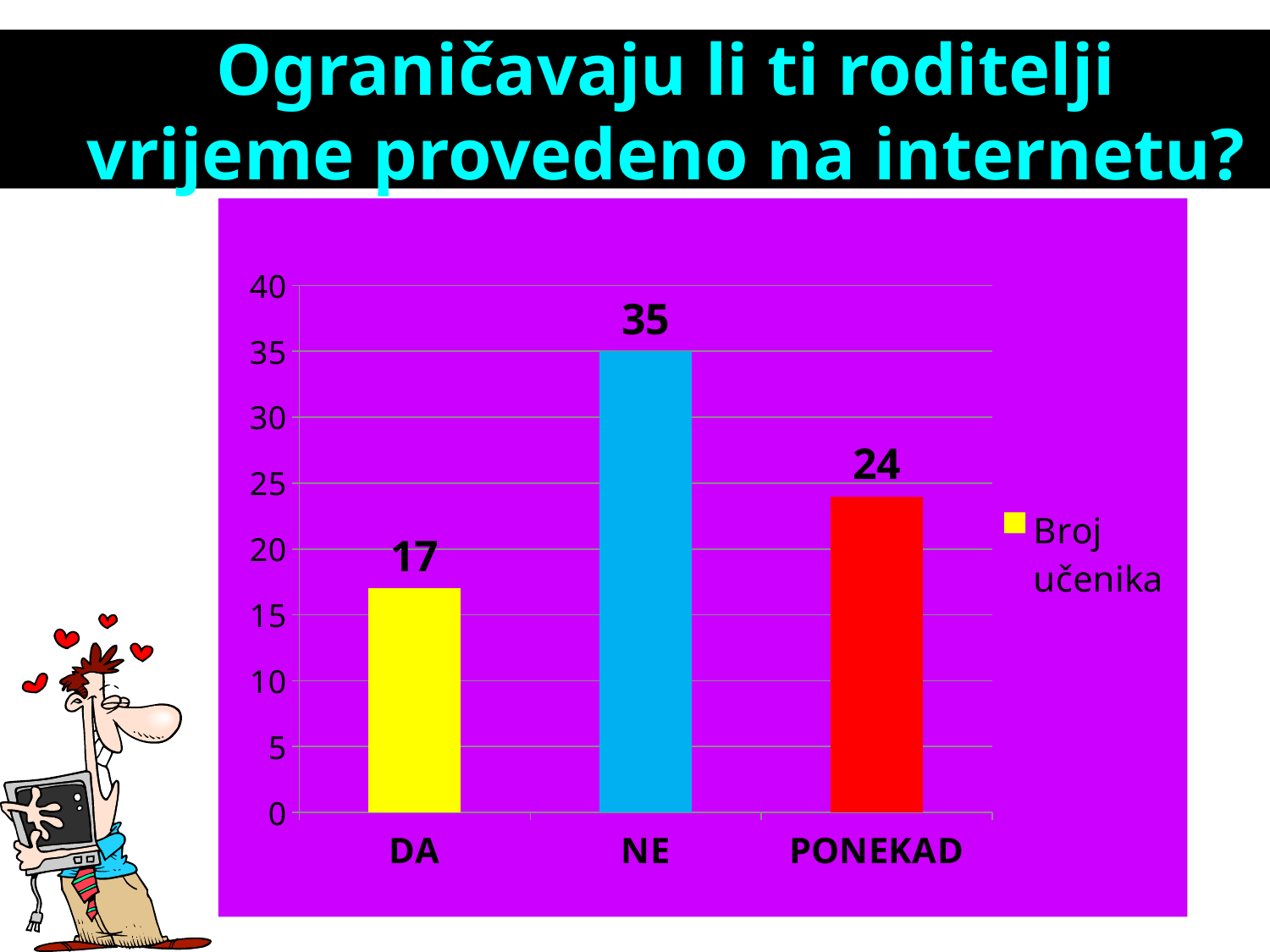
What is the difference between the values for PONEKAD and DA? 7 What is the value for DA? 17 What is the value for NE? 35 What is the value for PONEKAD? 24 What series name does the legend list? Broj učenika What is the difference between the values for NE and DA? 18 Which category has the lowest value? DA How many categories are shown on the x axis? 3 What kind of chart is shown on the slide? bar chart Which category has the highest value? NE Is the value for NE greater or less than 30? greater Which is larger, the value for PONEKAD or the value for DA? PONEKAD